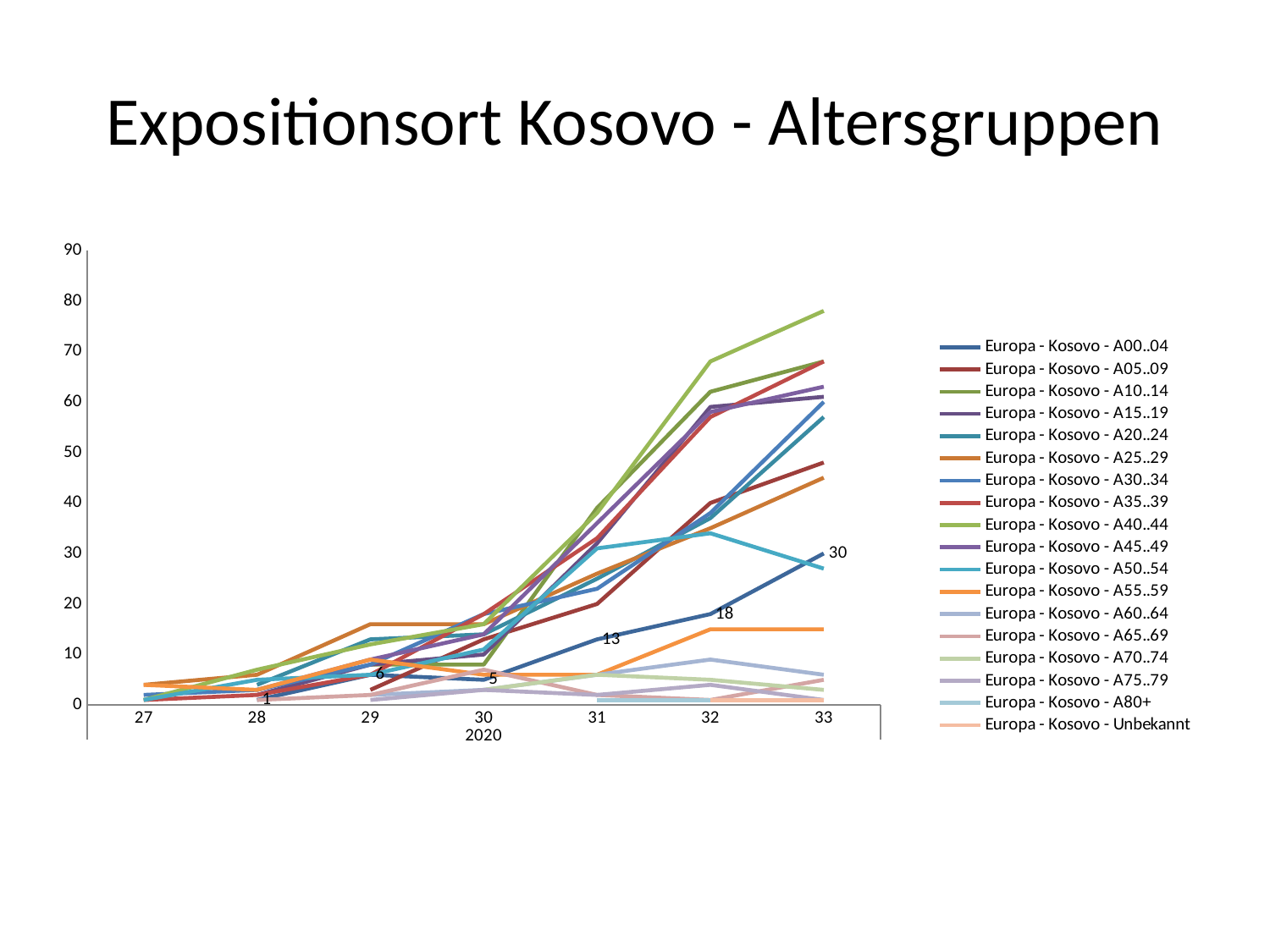
How many series does the legend list? 18 What kind of chart is shown on the slide? line chart What is the value for Europa - Kosovo - A00..04 at 31? 13 Which series has the highest value at 33? Europa - Kosovo - A40..44 What is the title of the slide? Expositionsort Kosovo - Altersgruppen What is the value for Europa - Kosovo - A00..04 at 33? 30 What is the difference between the Europa - Kosovo - A00..04 values at 33 and at 32? 12 Is the value for Europa - Kosovo - A40..44 at 33 greater or less than 70? greater Is the value for Europa - Kosovo - A55..59 at 33 greater or less than 20? less What is the value for Europa - Kosovo - A00..04 at 32? 18 Does the Europa - Kosovo - A00..04 series rise or fall from 31 to 33? rise How many points are on the x axis of the chart? 7